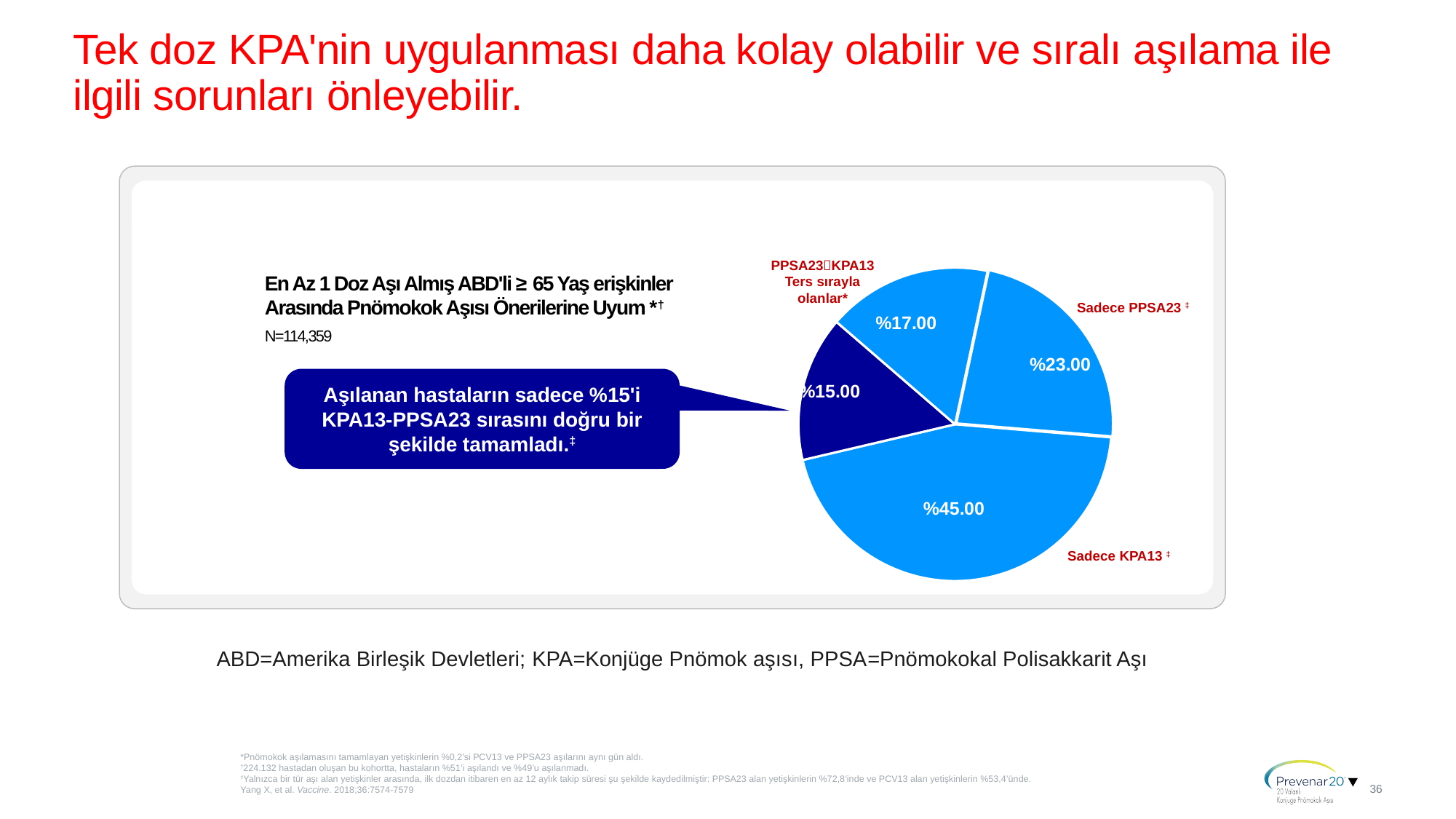
What is the value of the 'PPSA23→KPA13 Ters sırayla olanlar' slice in the pie chart? %17.00 What kind of chart is shown on the slide? pie chart Which slice of the pie chart is the largest? Sadece KPA13 How many slices does the pie chart have? 4 Which is larger in the pie chart: 'Sadece PPSA23' or 'PPSA23→KPA13 Ters sırayla olanlar'? Sadece PPSA23 Which slice of the pie chart is coloured dark blue? the %15.00 slice What is the value of the 'Sadece PPSA23' slice in the pie chart? %23.00 What is the difference between the 'Sadece KPA13' slice and the 'Sadece PPSA23' slice in the pie chart? 22 percentage points What is the value of the 'Sadece KPA13' slice in the pie chart? %45.00 What is the difference between the 'Sadece PPSA23' slice and the 'PPSA23→KPA13 Ters sırayla olanlar' slice? 6 percentage points According to the callout on the slide, what percentage of vaccinated patients completed the KPA13-PPSA23 sequence correctly? %15 What is the sample size (N) stated next to the pie chart? N=114,359